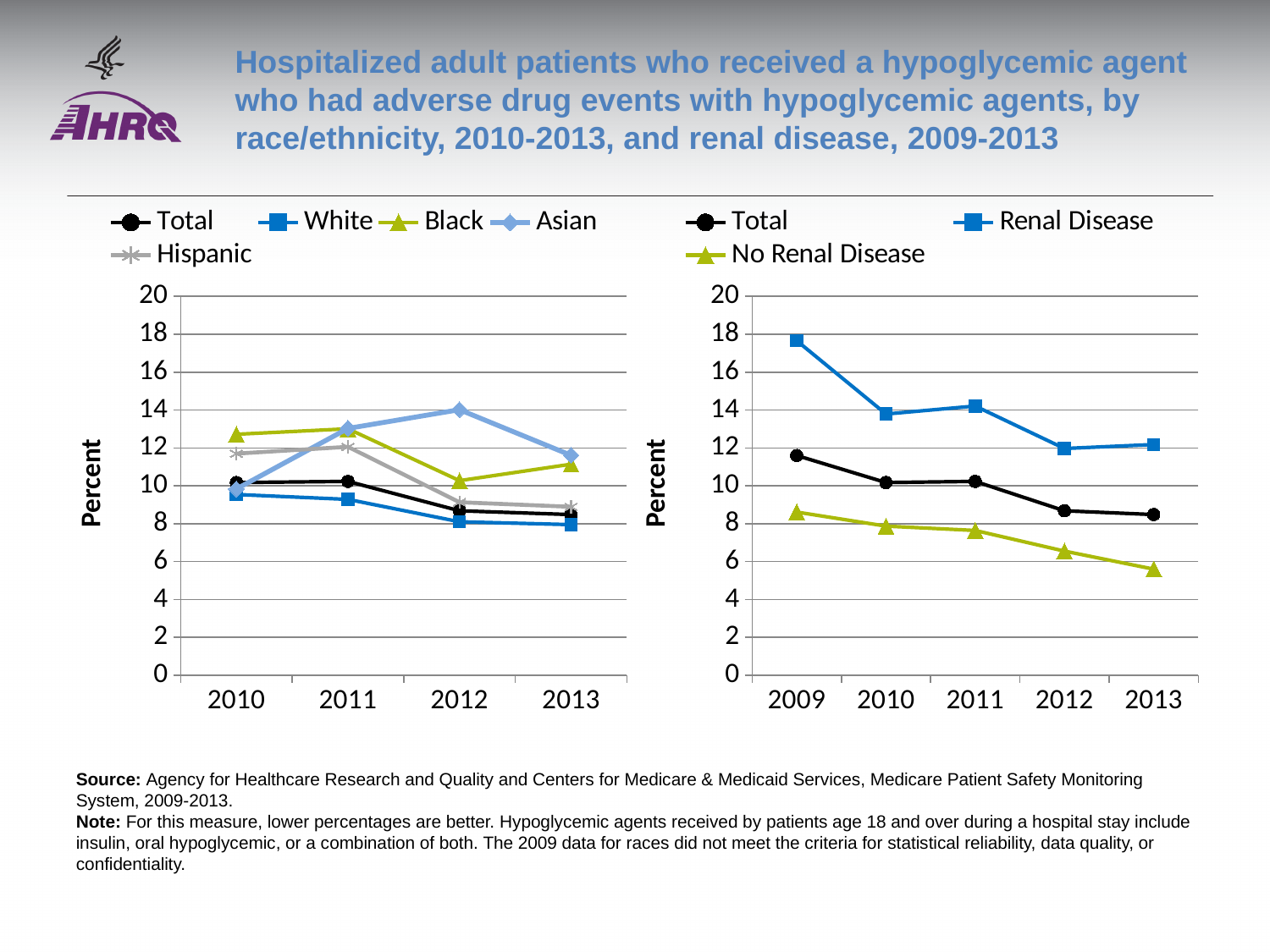
What is the label on the vertical axis of the left chart (by race/ethnicity)? Percent In the right chart (by renal disease), in which year is the Renal Disease value highest? 2009 What kind of chart is the left chart (by race/ethnicity)? Line chart In the right chart (by renal disease), is the value for No Renal Disease in 2013 greater or less than 6? less In the right chart (by renal disease), does the No Renal Disease line rise or fall from 2009 to 2013? Falls In the left chart (by race/ethnicity), which is larger in 2012, the value for Asian or the value for White? Asian How many years are shown on the x axis of the right chart (by renal disease)? 5 In the right chart (by renal disease), is the value for Renal Disease in 2009 greater or less than 16? greater How many years are shown on the x axis of the left chart (by race/ethnicity)? 4 How many series does the legend of the left chart (by race/ethnicity) list? 5 How many series does the legend of the right chart (by renal disease) list? 3 In the left chart (by race/ethnicity), is the value for Asian in 2012 greater or less than 12? greater